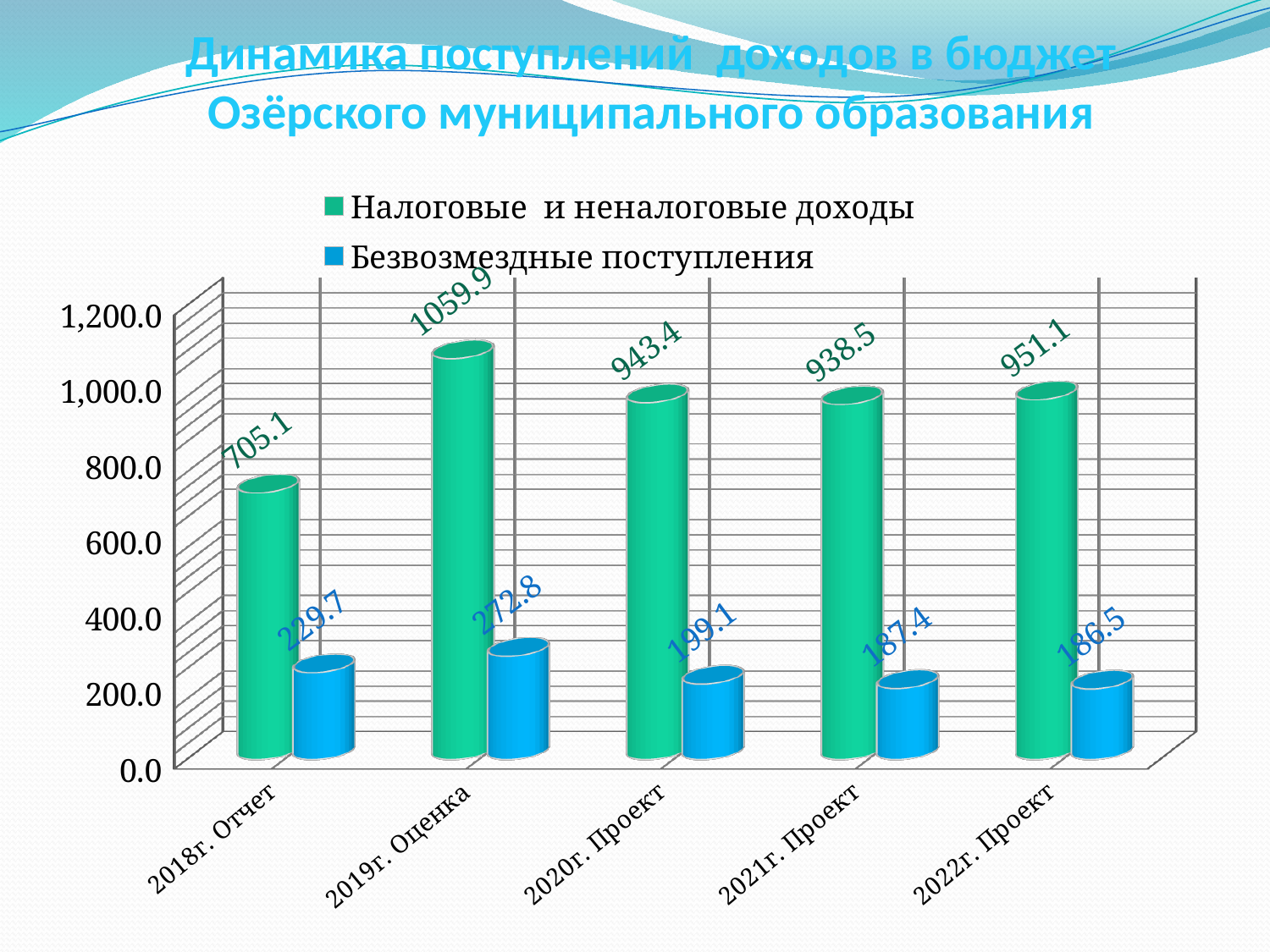
How many series does the legend list? 2 What is the value of Безвозмездные поступления for 2018г. Отчет? 229.7 In which category is Налоговые и неналоговые доходы highest? 2019г. Оценка What is the value of Безвозмездные поступления for 2022г. Проект? 186.5 What kind of chart is shown on the slide? Bar chart What is the difference between Налоговые и неналоговые доходы in 2019г. Оценка and 2018г. Отчет? 354.8 Does Безвозмездные поступления rise or fall from 2019г. Оценка to 2022г. Проект? Fall What colour represents Безвозмездные поступления in the chart? Blue What is the value of Налоговые и неналоговые доходы for 2019г. Оценка? 1059.9 Which is larger: Безвозмездные поступления in 2019г. Оценка or in 2020г. Проект? 2019г. Оценка In which category is Безвозмездные поступления lowest? 2022г. Проект How many categories are shown on the x axis? 5